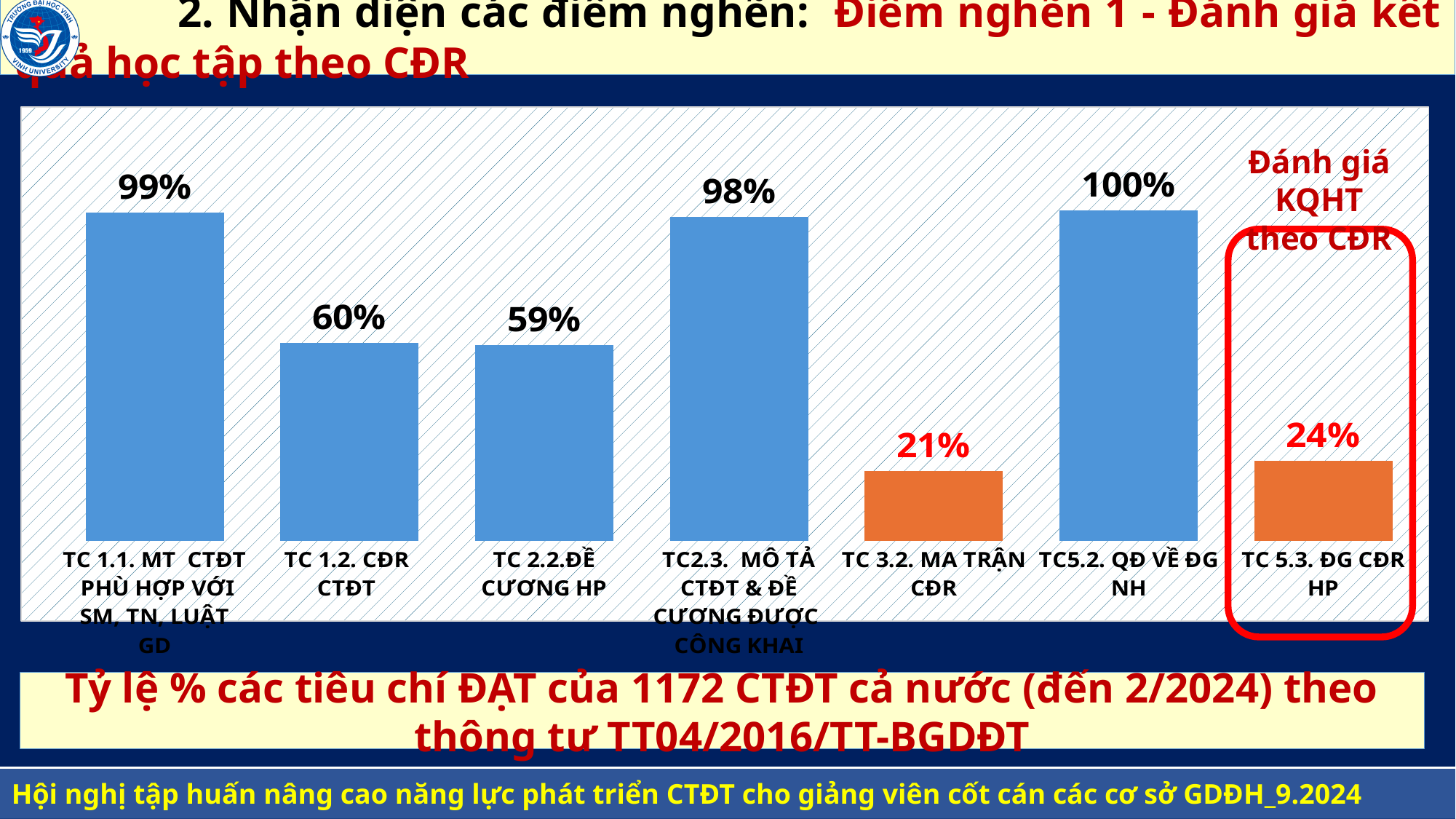
What is the value for TC2.3. MÔ TẢ CTĐT & ĐỀ CƯƠNG ĐƯỢC CÔNG KHAI? 98% Which category has the lowest value? TC 3.2. MA TRẬN CĐR Which is larger, the value for TC 2.2. ĐỀ CƯƠNG HP or the value for TC 5.3. ĐG CĐR HP? TC 2.2. ĐỀ CƯƠNG HP What is the difference between the values for TC 1.1. MT CTĐT PHÙ HỢP VỚI SM, TN, LUẬT GD and TC 1.2. CĐR CTĐT? 39% How many categories are shown in the chart? 7 What is the value for TC 5.3. ĐG CĐR HP? 24% What kind of chart is shown on the slide? Bar chart What is the difference between the values for TC 5.3. ĐG CĐR HP and TC 3.2. MA TRẬN CĐR? 3% Which category has the highest value? TC5.2. QĐ VỀ ĐG NH Which two categories are drawn in orange rather than blue? TC 3.2. MA TRẬN CĐR and TC 5.3. ĐG CĐR HP What is the value for TC 3.2. MA TRẬN CĐR? 21% What is the value for TC 1.2. CĐR CTĐT? 60%